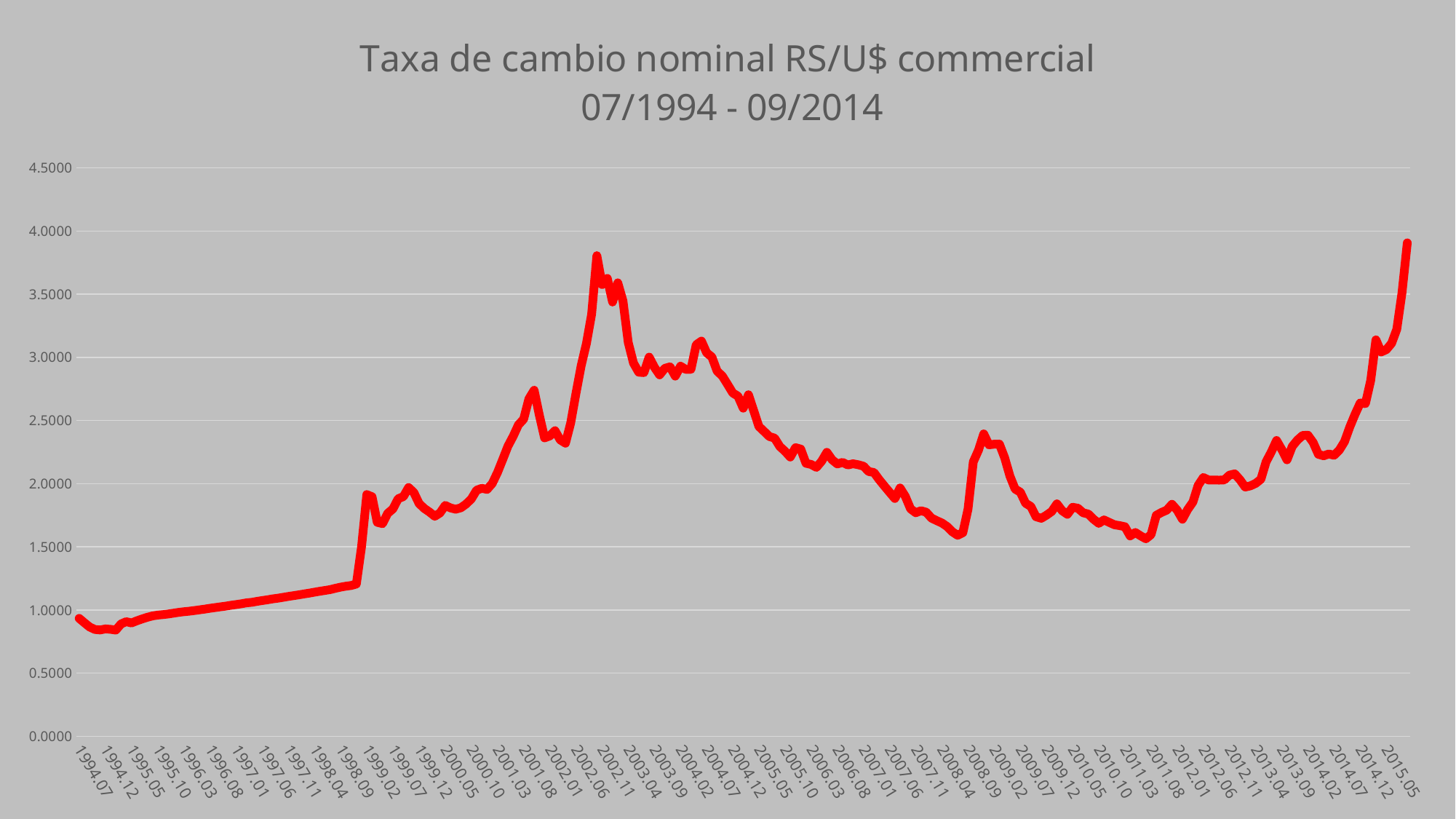
What kind of chart is shown on the slide? line chart What is the title of the chart? Taxa de cambio nominal RS/U$ commercial 07/1994 - 09/2014 Is the value for 2004.02 greater or less than 2.5000? greater Does the line generally rise or fall between 2011.03 and 2015.05? rise Is the value for 1994.07 greater or less than 1.5000? less Is the value for 2011.03 greater or less than 2.0000? less Does the line generally rise or fall between 1994.07 and 1998.09? rise Does the line generally rise or fall between 2002.11 and 2007.06? fall What is the highest value shown on the vertical axis? 4.5000